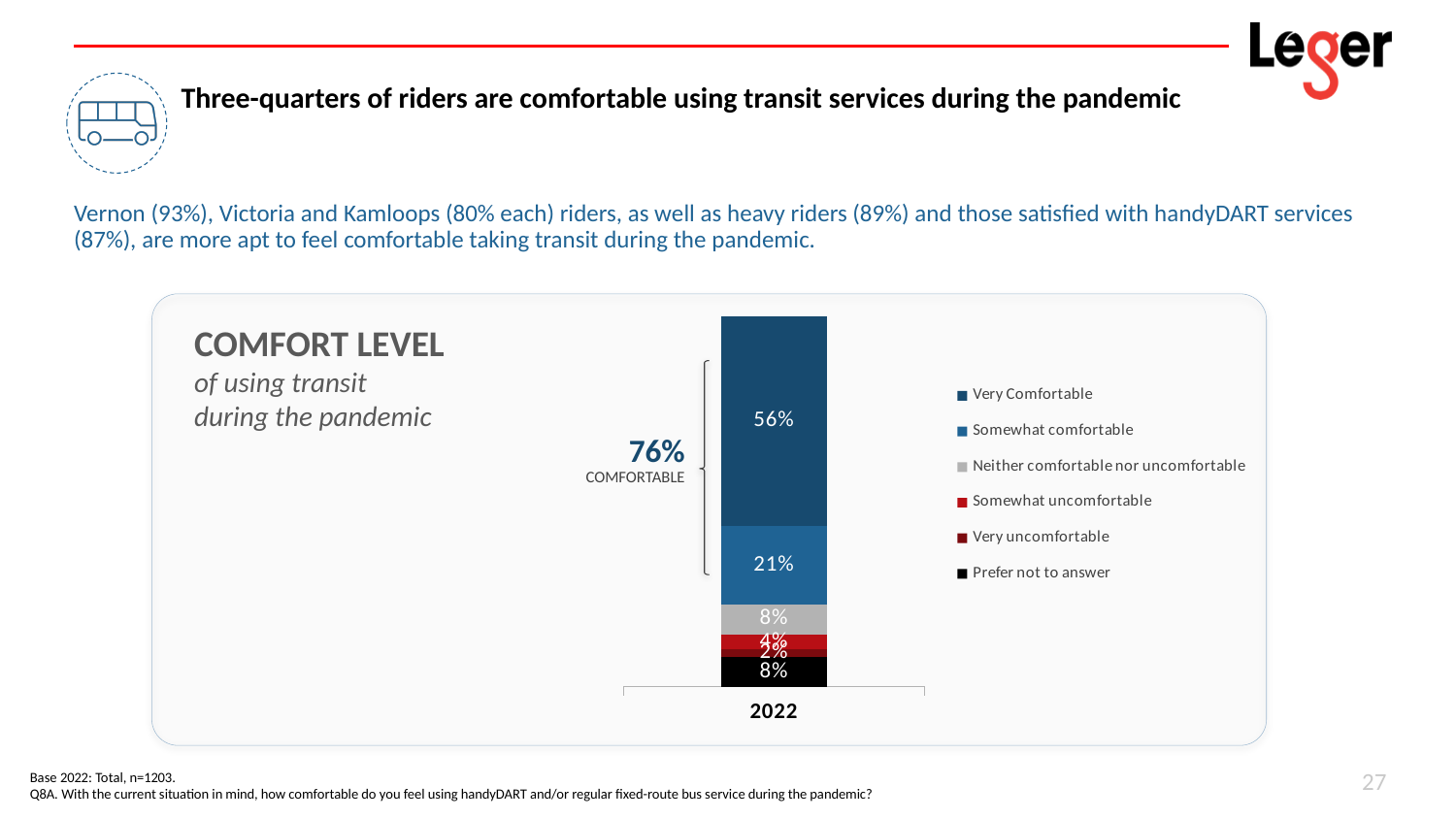
What combined percentage of riders is labelled as COMFORTABLE? 76% What is the difference between the Very Comfortable and Somewhat comfortable percentages? 35% What is the title of the chart? COMFORT LEVEL of using transit during the pandemic How many series does the legend list? 6 What kind of chart is shown on the slide? stacked bar chart What percentage of riders are Somewhat comfortable? 21% Which response has the largest share of the bar? Very Comfortable What percentage of riders are Neither comfortable nor uncomfortable? 8% Which is larger, the Somewhat comfortable share or the Neither comfortable nor uncomfortable share? Somewhat comfortable Which year is shown on the x axis of the chart? 2022 What percentage of riders chose Prefer not to answer? 8% What percentage of riders are Very Comfortable using transit during the pandemic? 56%